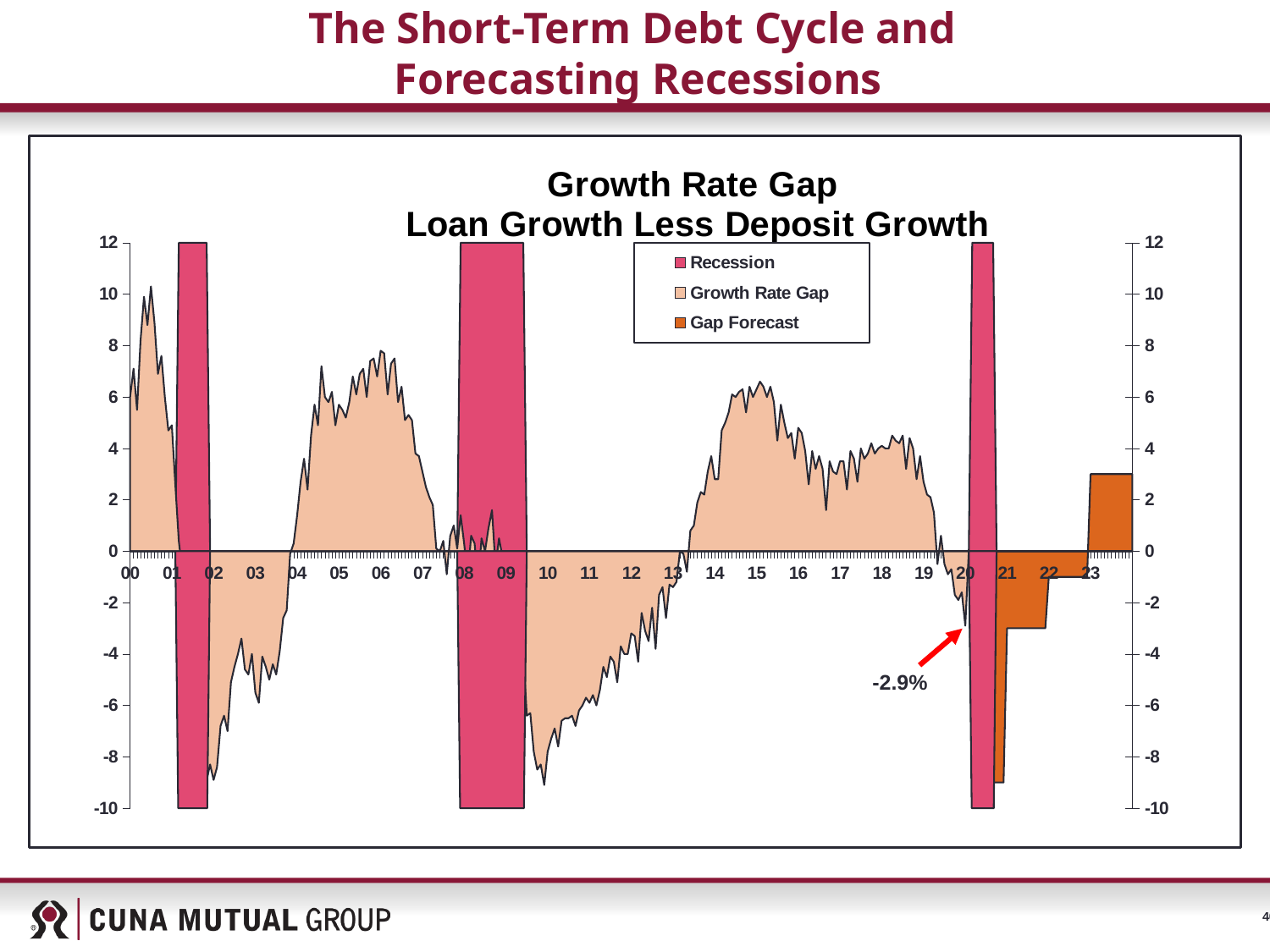
How many series does the chart legend list? 3 What colour is used for the Gap Forecast series? orange Is the Gap Forecast for 2021 greater or less than -6? greater Is the Growth Rate Gap at the start of 2002 greater or less than -6? less Is the Growth Rate Gap at the start of 2015 greater or less than 4? greater What is the title of the chart? Growth Rate Gap Loan Growth Less Deposit Growth How many recession bands are shaded on the chart? 3 What value is labeled with the red arrow near 2020? -2.9%